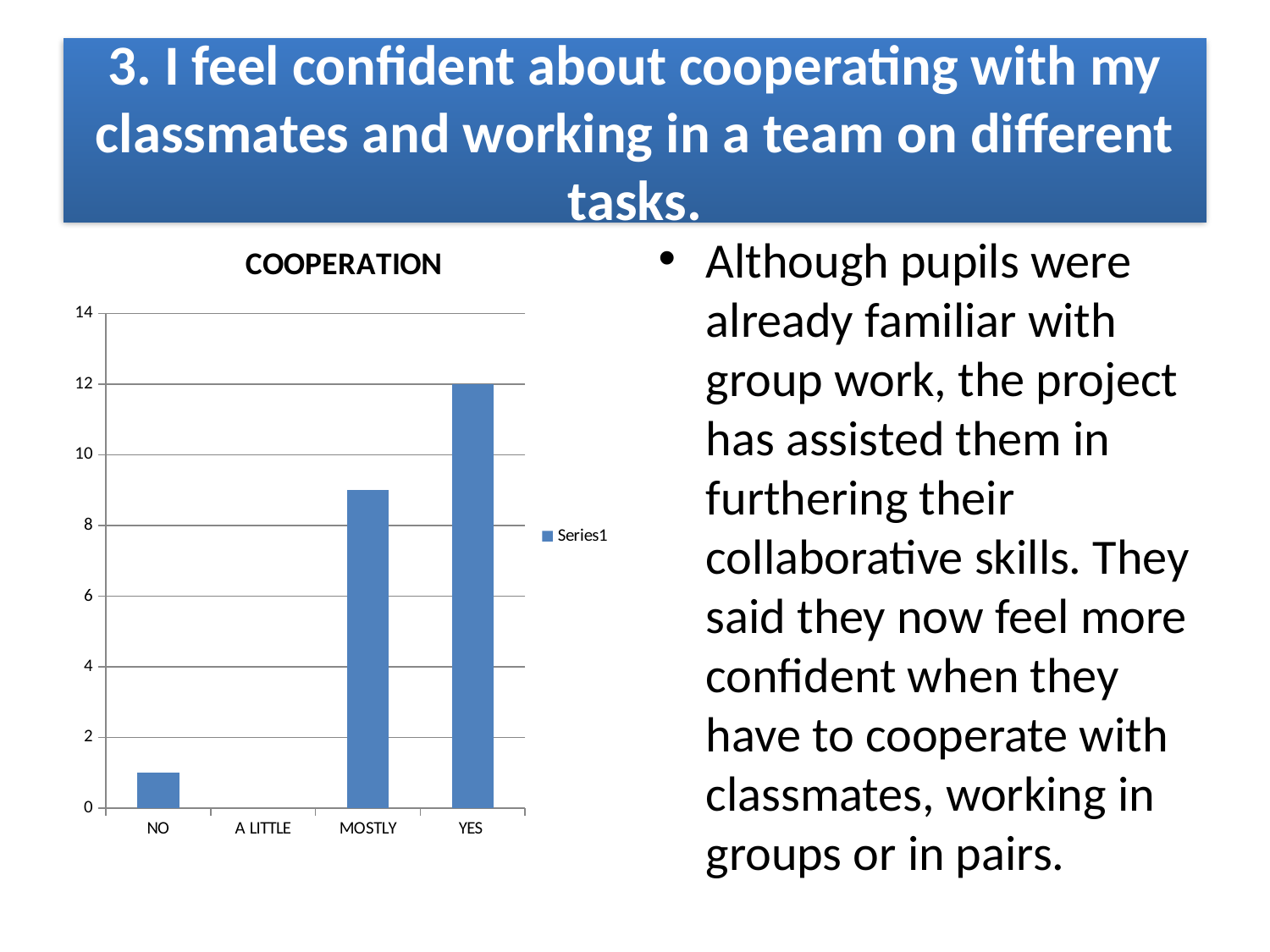
Is the value for NO greater or less than 2? less How many categories are shown on the x axis of the chart? 4 What is the value for YES in the chart? 12 Which category has the highest value in the chart? YES Which category has the lowest value in the chart? A LITTLE What kind of chart is shown on the slide? bar chart Is the value for MOSTLY greater or less than 8? greater Which has the larger value, MOSTLY or NO? MOSTLY Is the value for MOSTLY greater or less than 10? less How many series does the chart legend list? 1 What is the title of the chart? COOPERATION What is the name of the series shown in the chart legend? Series1